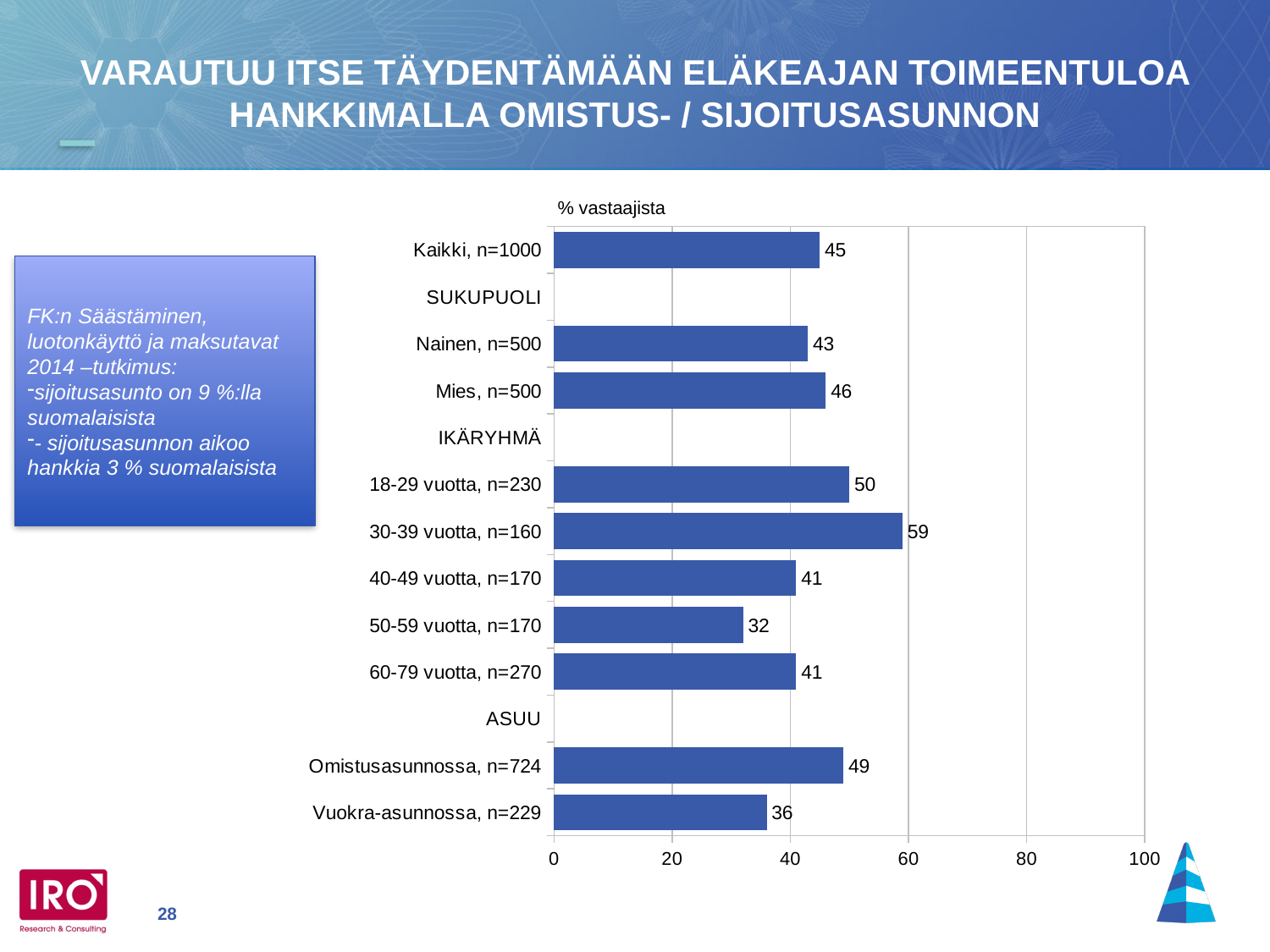
Which category has the highest value? 30-39 vuotta, n=160 What is the difference between the values for Mies, n=500 and Nainen, n=500? 3 What is the maximum value shown on the horizontal axis? 100 What is the value for Kaikki, n=1000? 45 Is the value for 50-59 vuotta, n=170 greater or less than 40? less What is the value for Vuokra-asunnossa, n=229? 36 Which is larger, the value for 18-29 vuotta, n=230 or the value for 60-79 vuotta, n=270? 18-29 vuotta, n=230 What kind of chart is shown on the slide? bar chart What is the difference between the values for Omistusasunnossa, n=724 and Vuokra-asunnossa, n=229? 13 What label appears above the chart describing the unit of the values? % vastaajista Which category has the lowest value? 50-59 vuotta, n=170 What is the value for 30-39 vuotta, n=160? 59